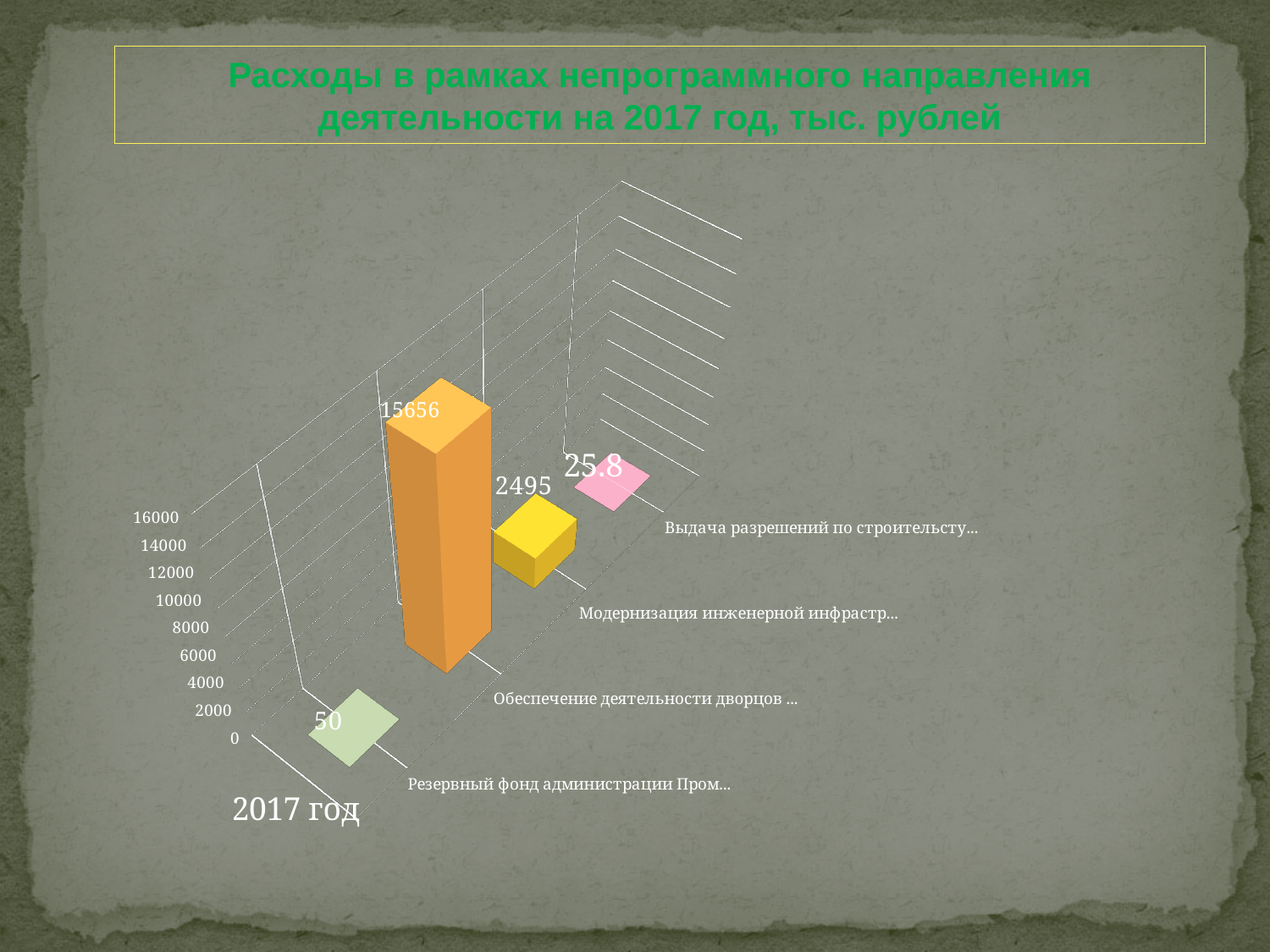
What value is shown for "Обеспечение деятельности дворцов ..."? 15656 What value is shown for "Модернизация инженерной инфрастр..."? 2495 Which is larger: the value for "Резервный фонд администрации Пром..." or the value for "Выдача разрешений по строительству..."? Резервный фонд администрации Пром... What value is shown for "Выдача разрешений по строительству..."? 25.8 Which category has the lowest value? Выдача разрешений по строительству... What is the difference between the values for "Обеспечение деятельности дворцов ..." and "Модернизация инженерной инфрастр..."? 13161 What kind of chart is shown on the slide? bar chart What year label is shown on the x axis of the chart? 2017 год What value is shown for "Резервный фонд администрации Пром..."? 50 Which category has the highest value? Обеспечение деятельности дворцов ... How many data series are plotted in the chart? 4 Is the value for "Обеспечение деятельности дворцов ..." greater or less than 14000? greater